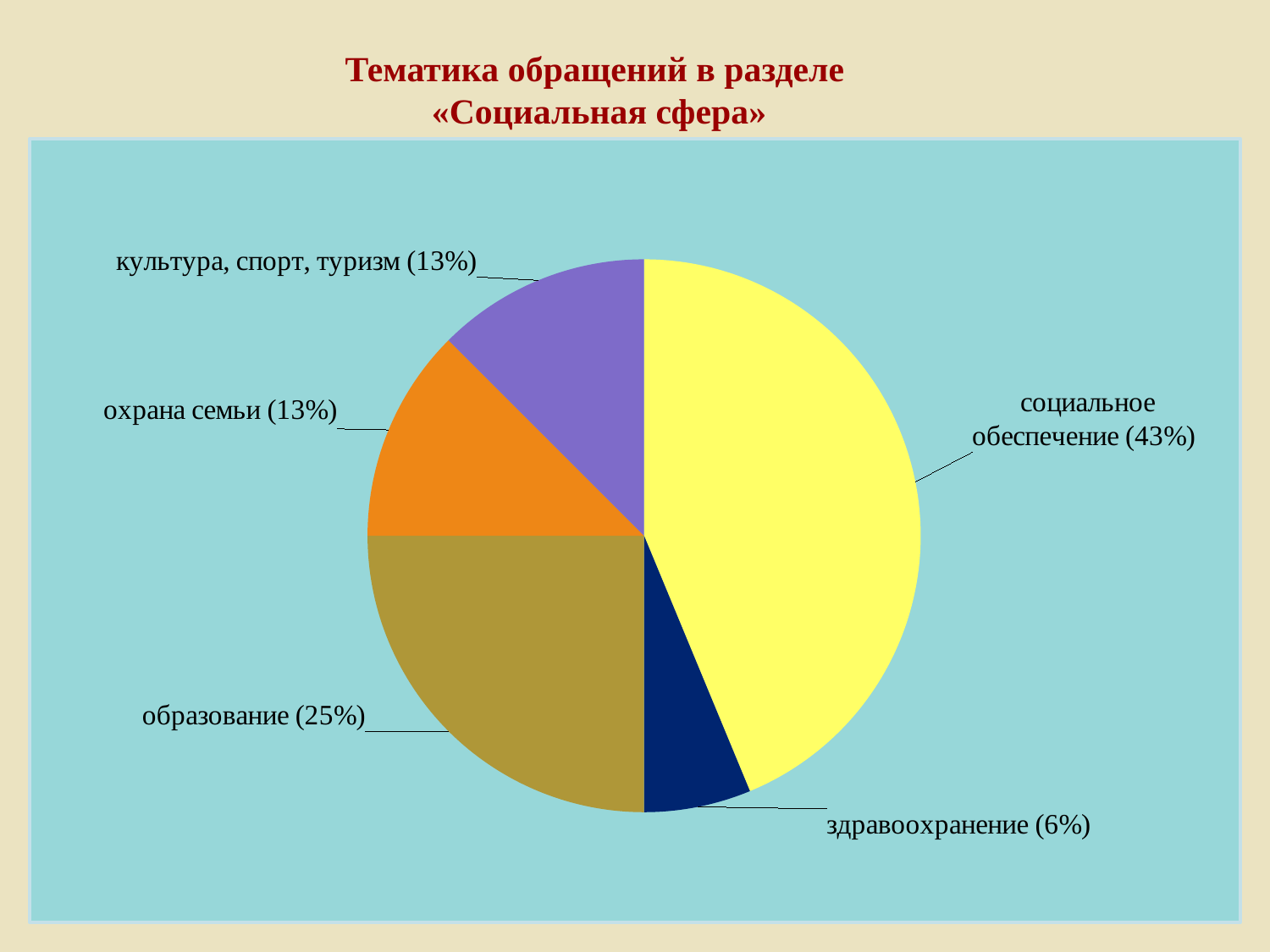
What is the difference in percentage points between социальное обеспечение and образование? 18 Which category has the smallest slice of the pie? здравоохранение Which category has the largest slice of the pie? социальное обеспечение What is the title of the chart? Тематика обращений в разделе «Социальная сфера» How many categories are shown in the pie chart? 5 What share of the pie does социальное обеспечение have? 43% What share of the pie does образование have? 25% What share of the pie does здравоохранение have? 6% What colour is the slice for здравоохранение? dark blue Which is larger, the share for образование or the share for охрана семьи? образование What kind of chart is shown on the slide? pie chart